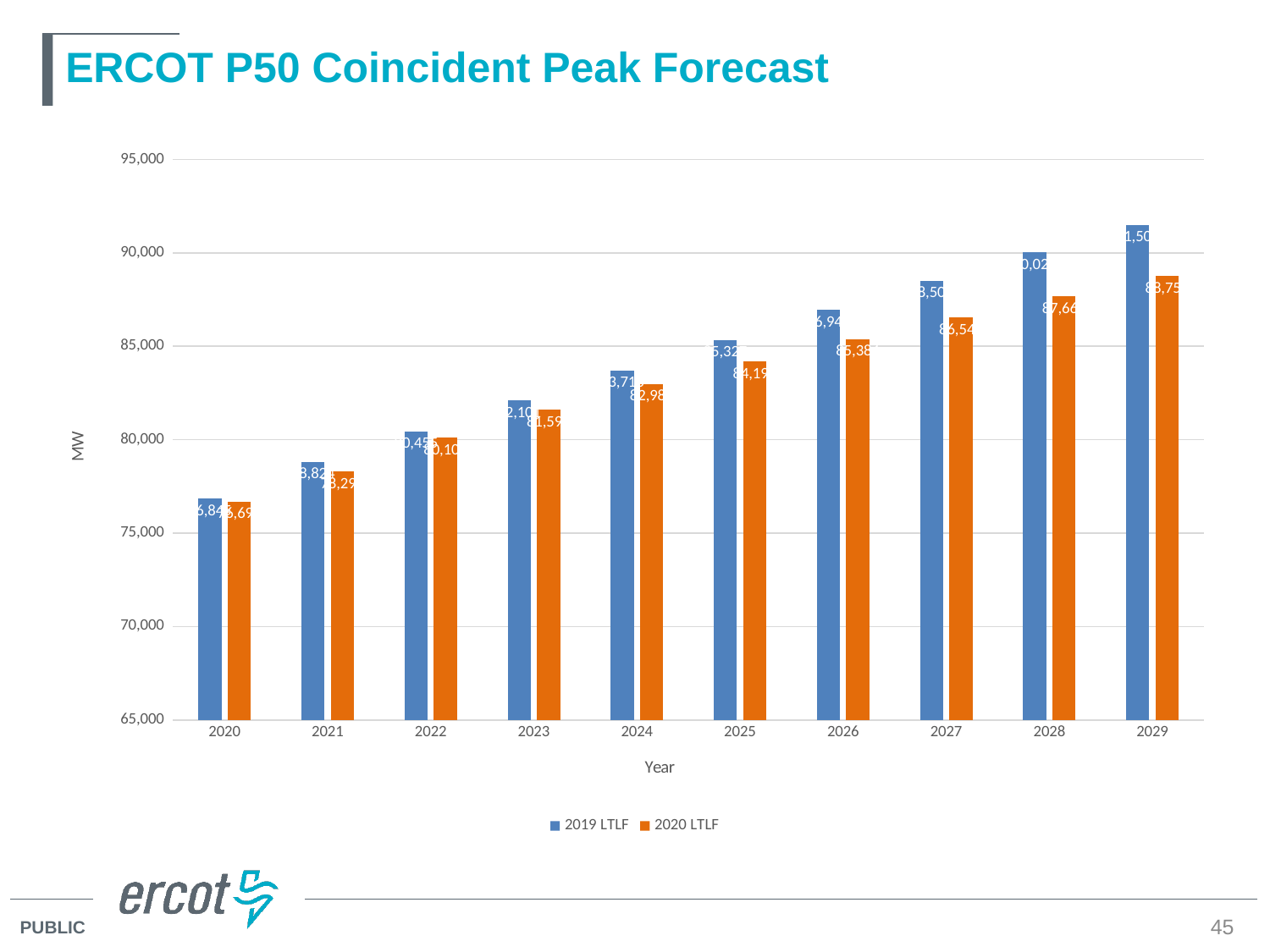
What is the label on the y axis? MW Is the 2020 LTLF value for 2029 greater or less than 90,000? less Is the 2019 LTLF value for 2026 greater or less than 85,000? greater Which year has the lowest 2020 LTLF value? 2020 How many years are shown on the x axis? 10 Is the 2019 LTLF value for 2029 greater or less than 90,000? greater What kind of chart is shown on the slide? bar chart Which year has the highest 2019 LTLF value? 2029 How many series does the legend list? 2 Do the 2019 LTLF values rise or fall from 2020 to 2029? rise For 2027, which is larger: the 2019 LTLF value or the 2020 LTLF value? 2019 LTLF